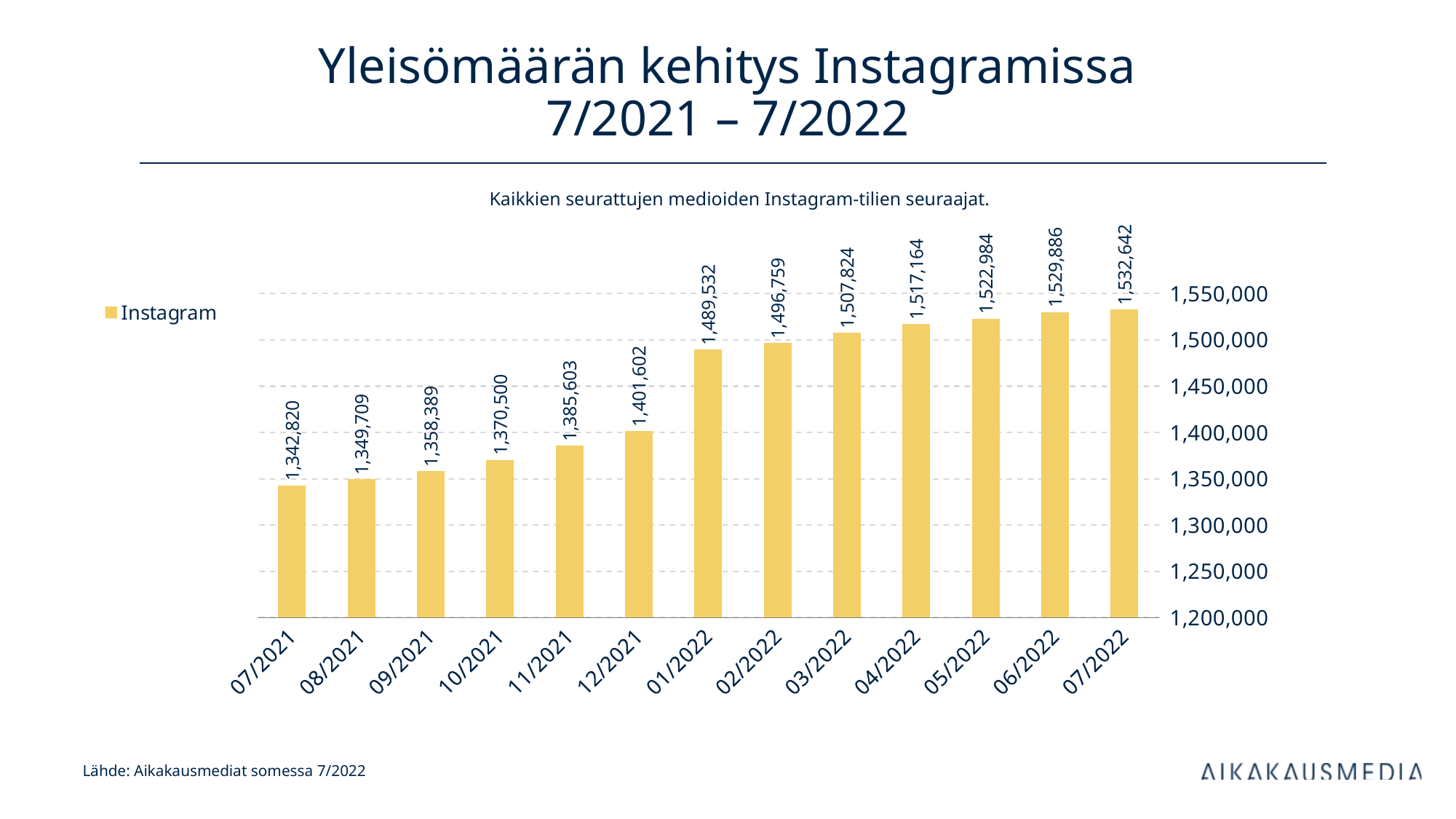
Which month has the highest Instagram follower count? 07/2022 Which month has the lowest Instagram follower count? 07/2021 Which month has more Instagram followers, 12/2021 or 01/2022? 01/2022 Is the value for 11/2021 greater or less than 1,400,000? less What is the Instagram follower count for 01/2022? 1,489,532 What is the difference in Instagram followers between 01/2022 and 12/2021? 87,930 What is the Instagram follower count for 07/2021? 1,342,820 How many months are shown on the x axis of the chart? 13 What kind of chart is shown on the slide? bar chart Do the Instagram follower values rise or fall from 07/2021 to 07/2022? rise What is the Instagram follower count for 07/2022? 1,532,642 What is the difference in Instagram followers between 07/2022 and 07/2021? 189,822